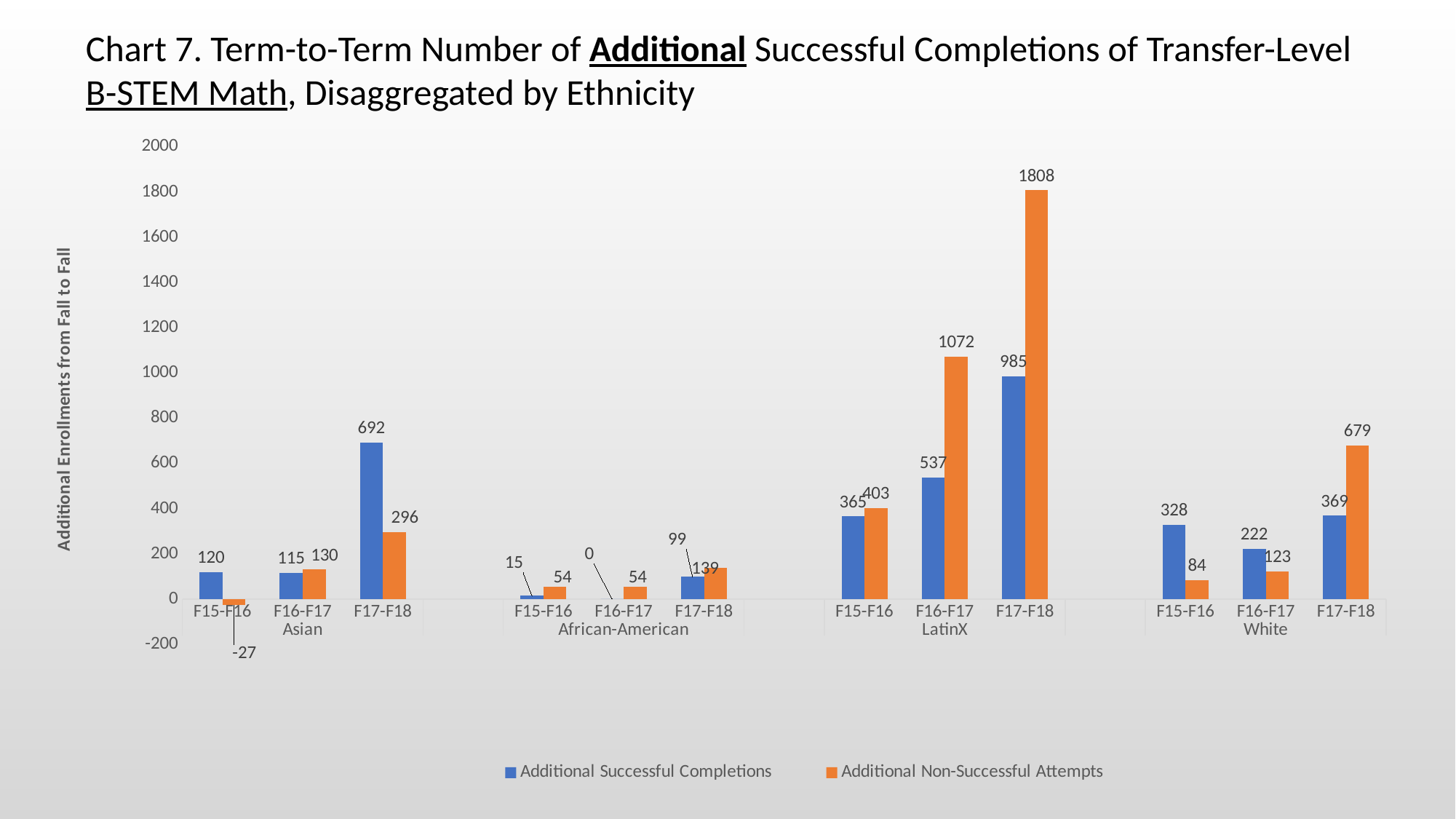
For White students in F15-F16, which is larger: Additional Successful Completions or Additional Non-Successful Attempts? Additional Successful Completions Which ethnicity and term has the highest value of Additional Non-Successful Attempts? LatinX, F17-F18 What is the value of Additional Non-Successful Attempts for LatinX students in F17-F18? 1808 What kind of chart is shown on the slide? Bar chart Do the Additional Successful Completions for LatinX students rise or fall from F15-F16 to F17-F18? Rise Which term has the lowest value of Additional Successful Completions for White students? F16-F17 What is the value of Additional Non-Successful Attempts for Asian students in F15-F16? -27 What is the difference between Additional Non-Successful Attempts and Additional Successful Completions for LatinX students in F17-F18? 823 How many series does the legend list? 2 What is the value of Additional Successful Completions for Asian students in F17-F18? 692 How many ethnicity groups are shown on the x axis? 4 What is the value of Additional Successful Completions for African-American students in F16-F17? 0